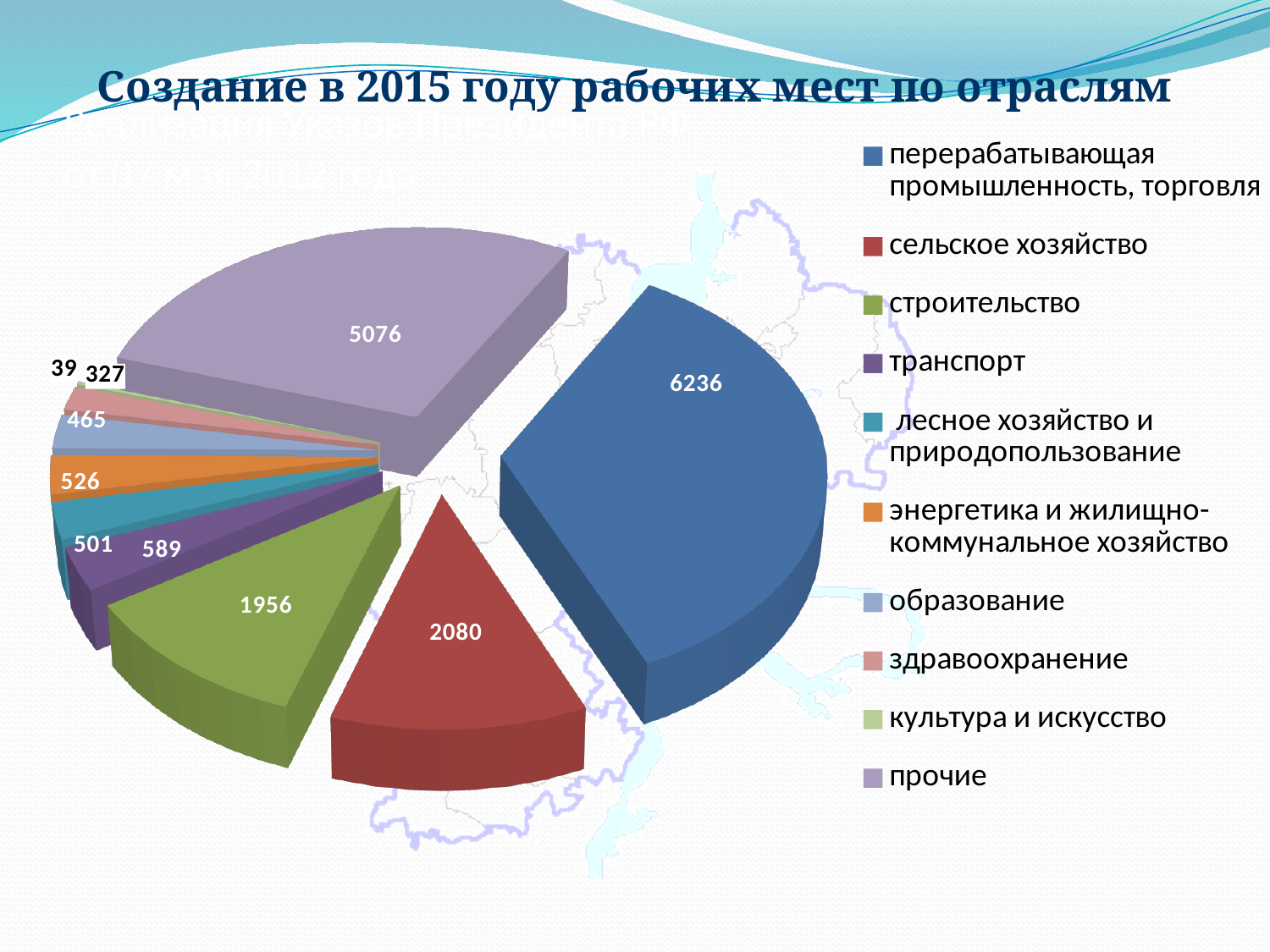
What is the value for сельское хозяйство? 2080 How many categories does the legend list? 10 What is the value for перерабатывающая промышленность, торговля? 6236 What kind of chart is shown on the slide? pie chart What is the value for прочие? 5076 What is the value for строительство? 1956 What is the difference between the values for сельское хозяйство and строительство? 124 Which category has the smallest value? культура и искусство What is the title of the chart? Создание в 2015 году рабочих мест по отраслям Which category has the largest value? перерабатывающая промышленность, торговля Which is larger, the value for транспорт or the value for образование? транспорт What is the value for культура и искусство? 39